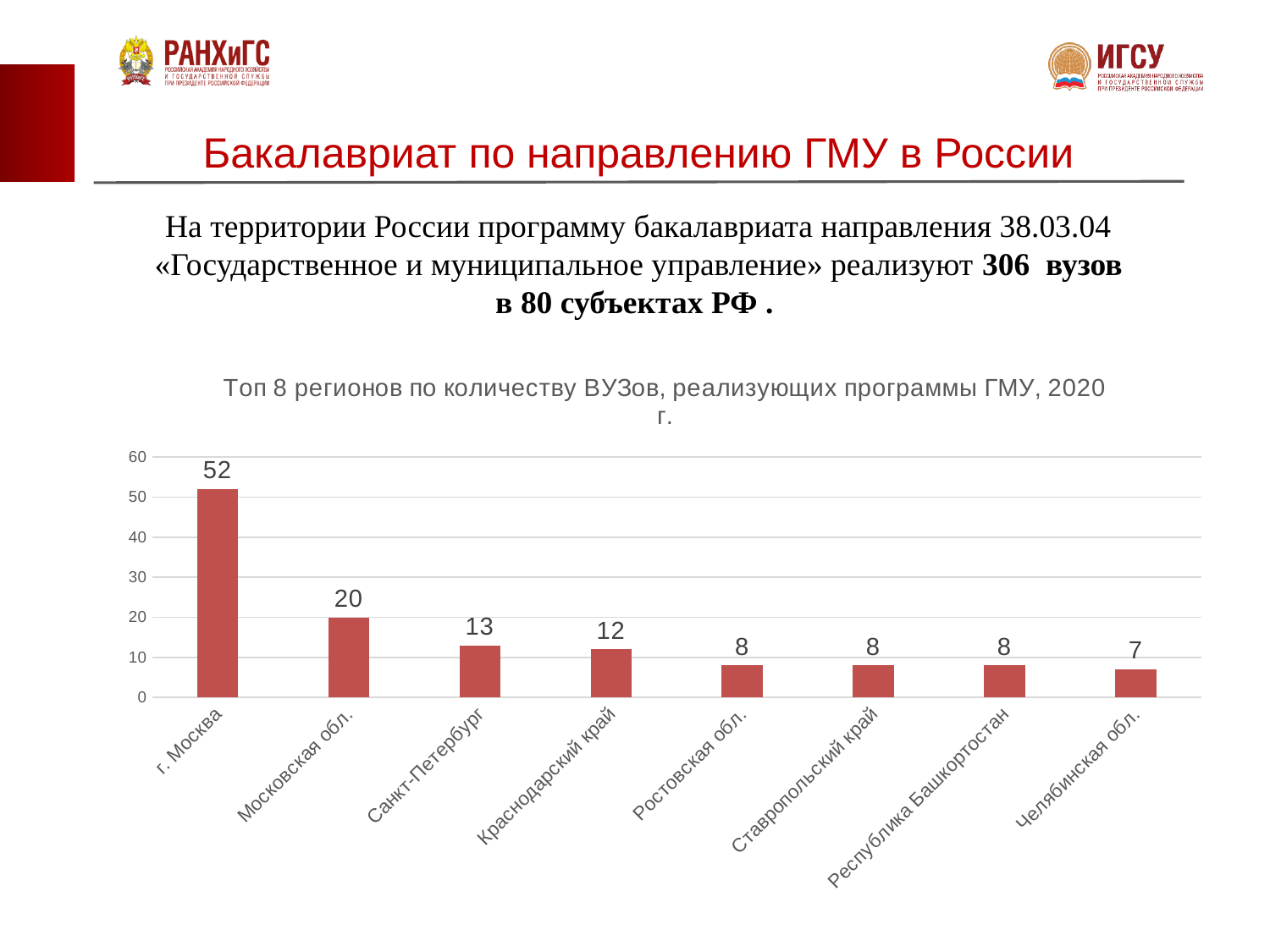
What kind of chart is shown on the slide? bar chart What is the value for Краснодарский край? 12 What is the value for г. Москва? 52 What is the difference between the values for г. Москва and Московская обл.? 32 Which is larger, the value for Санкт-Петербург or the value for Краснодарский край? Санкт-Петербург Which region has the highest value? г. Москва Do the values rise or fall from left to right along the x axis? fall What is the value for Санкт-Петербург? 13 How many regions are shown in the chart? 8 What is the title of the chart? Топ 8 регионов по количеству ВУЗов, реализующих программы ГМУ, 2020 г. Is the value for Московская обл. greater or less than 30? less Which region has the lowest value? Челябинская обл.